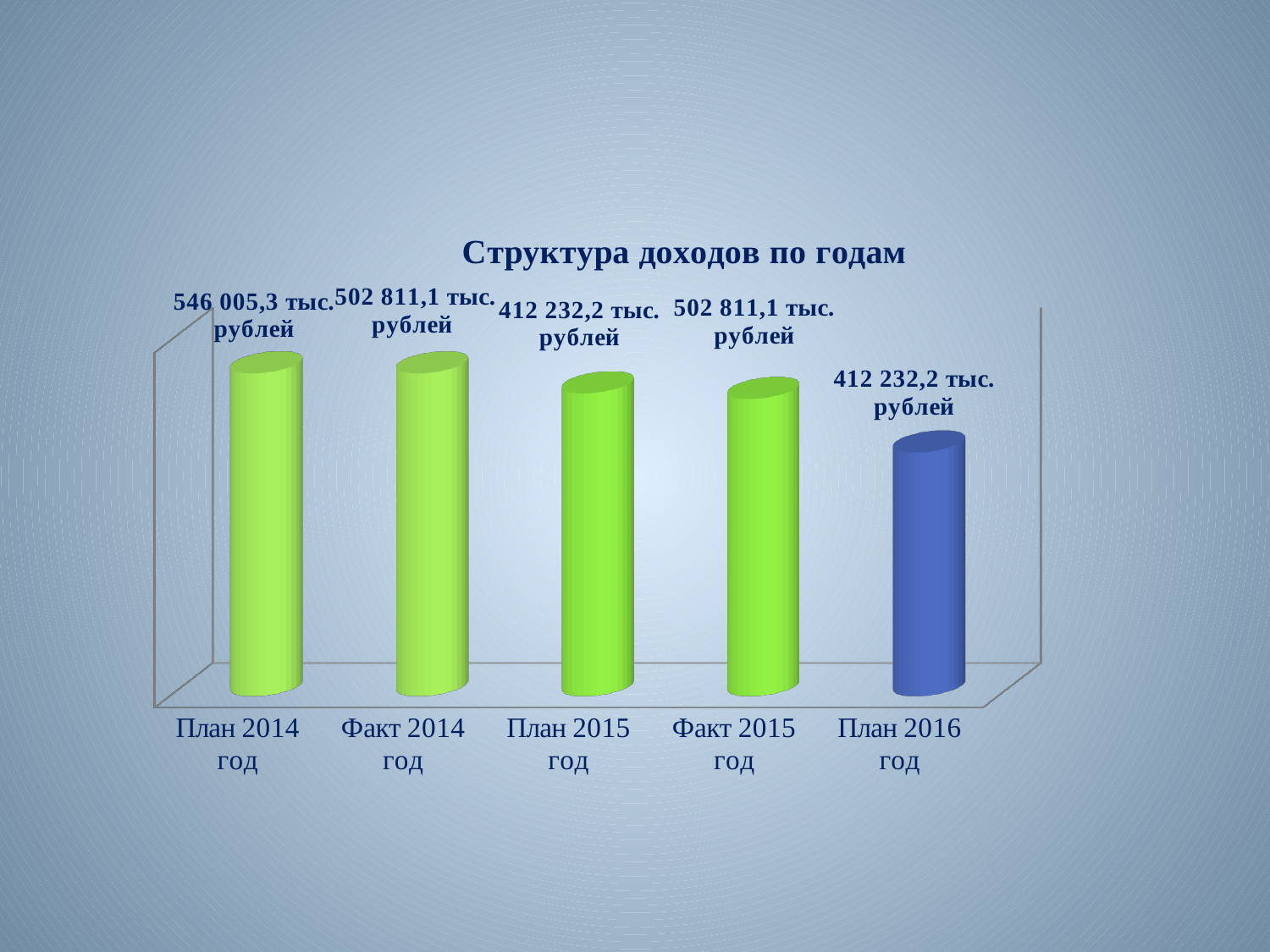
What is the title of the chart? Структура доходов по годам What is the value for План 2015 год? 412 232,2 тыс. рублей What is the difference between the values for Факт 2015 год and План 2016 год? 90 578,9 тыс. рублей How many categories are shown on the x axis? 5 What is the value for План 2016 год? 412 232,2 тыс. рублей What is the value for Факт 2014 год? 502 811,1 тыс. рублей Which is larger, the value for План 2014 год or Факт 2014 год? План 2014 год What is the value for Факт 2015 год? 502 811,1 тыс. рублей What is the difference between the values for План 2014 год and Факт 2014 год? 43 194,2 тыс. рублей What kind of chart is shown on the slide? Bar chart Which category has the highest value? План 2014 год What is the value for План 2014 год? 546 005,3 тыс. рублей